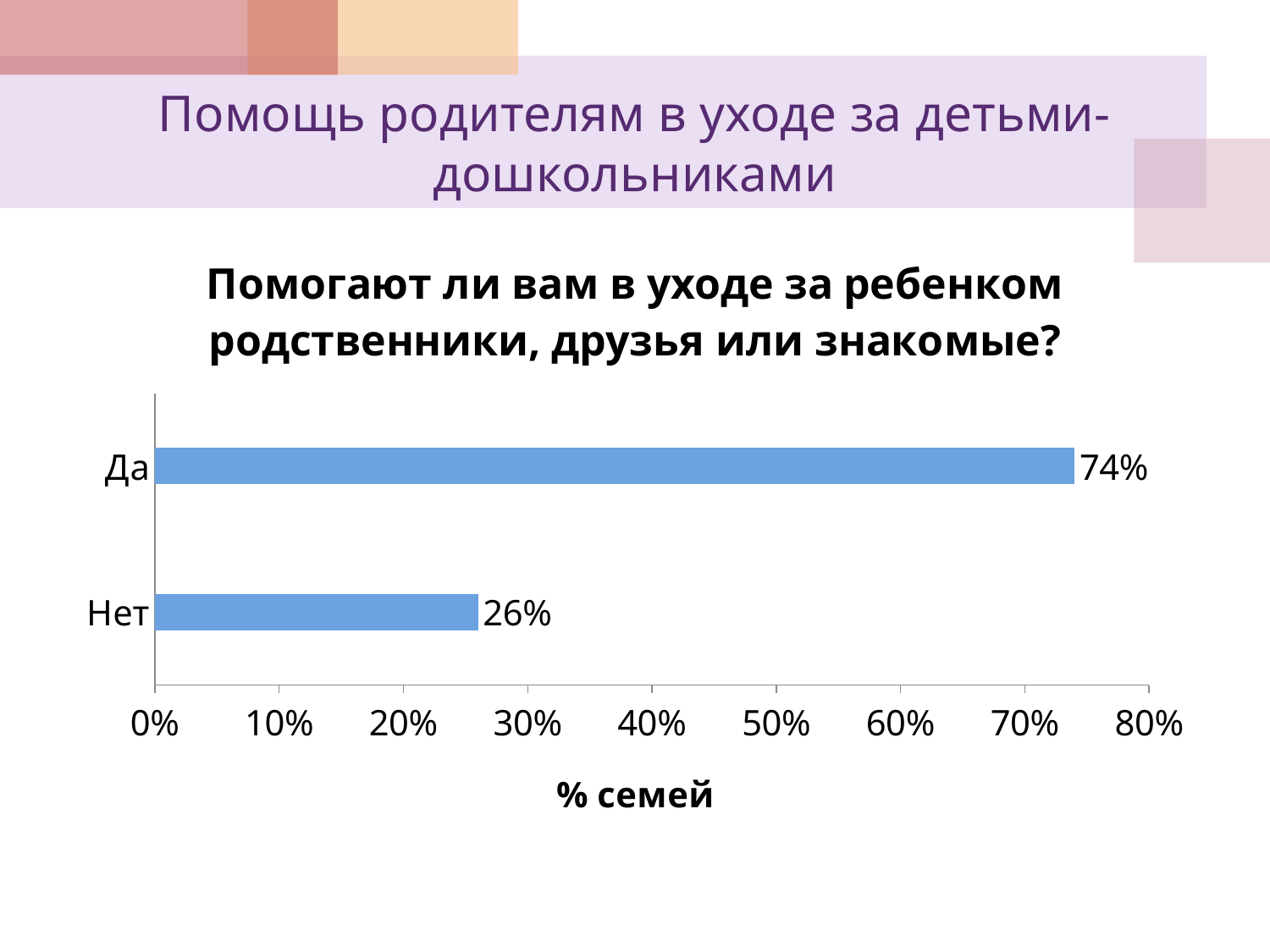
What is the difference between the values for "Да" and "Нет"? 48% How many categories are shown in the chart? 2 Is the value for "Да" greater or less than 70%? greater What is the title of the chart? Помогают ли вам в уходе за ребенком родственники, друзья или знакомые? What is the label of the horizontal axis? % семей Which is larger, the value for "Да" or the value for "Нет"? Да Which category has the highest value? Да What is the value for "Да"? 74% What is the value for "Нет"? 26% What kind of chart is shown on the slide? bar chart Is the value for "Нет" greater or less than 30%? less Which category has the lowest value? Нет